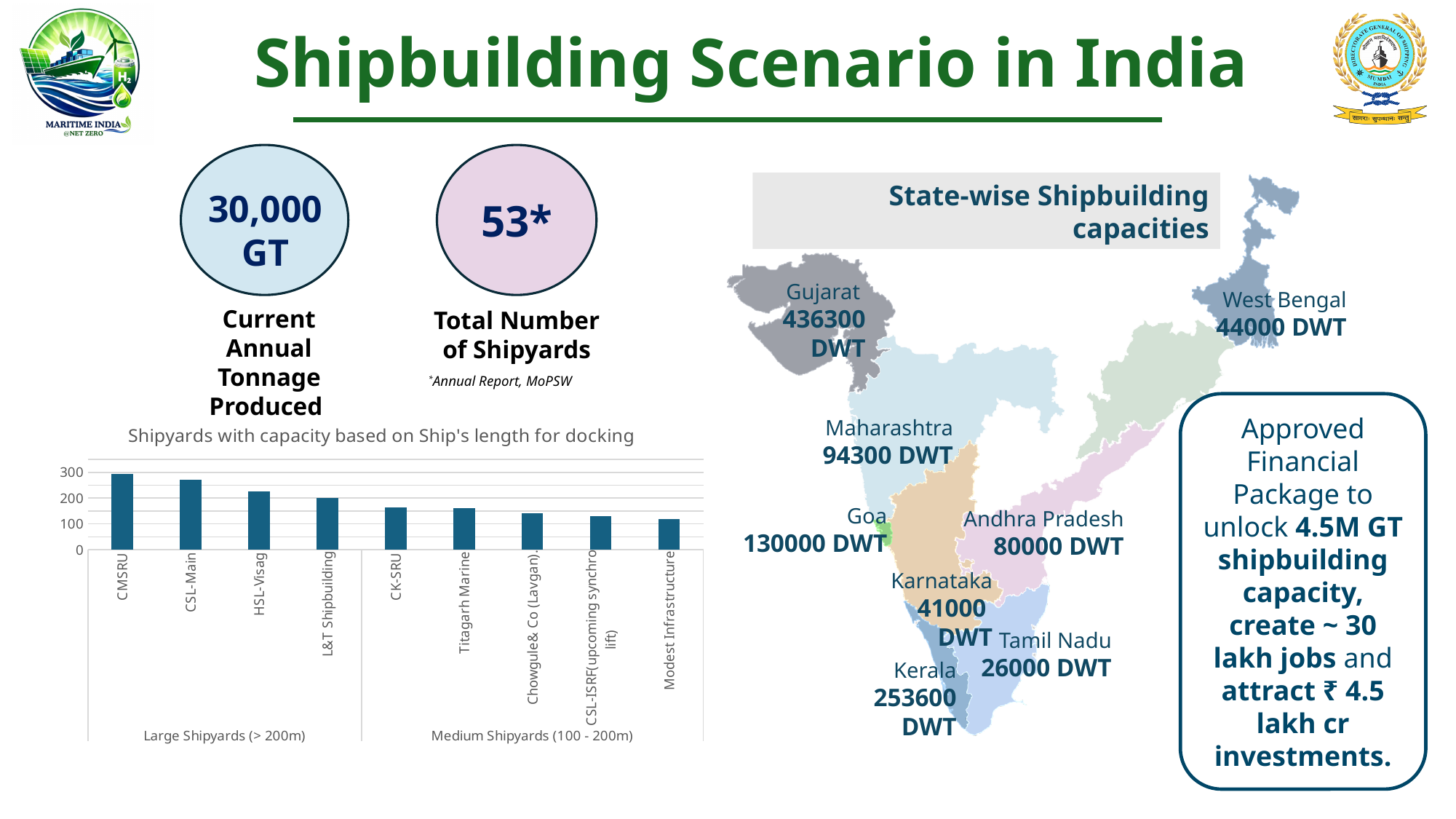
Which shipyard has the highest bar in the chart? CMSRU Is the value for CK-SRU greater or less than 200? less Which has the larger value, CMSRU or Modest Infrastructure? CMSRU Is the value for Modest Infrastructure greater or less than 100? greater Is the value for CMSRU greater or less than 200? greater Do the bar values generally rise or fall from left to right across the chart? fall What is the title of the bar chart? Shipyards with capacity based on Ship's length for docking How many shipyards are plotted in the bar chart? 9 What kind of chart is shown on the slide? bar chart What are the two shipyard groups labelled along the bottom of the bar chart? Large Shipyards (> 200m) and Medium Shipyards (100 - 200m)